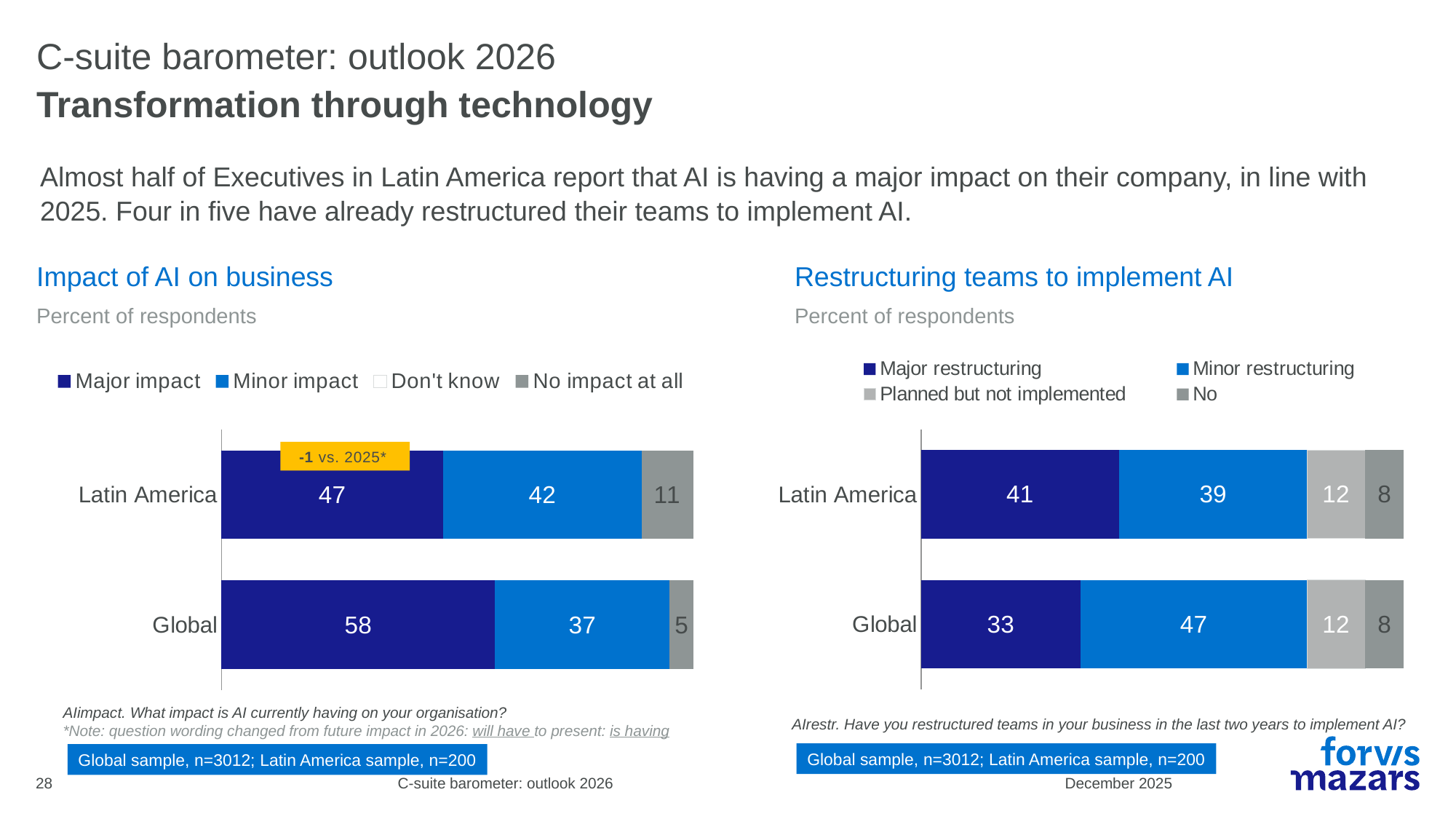
What kind of chart is the 'Restructuring teams to implement AI' chart? Stacked bar chart In the 'Restructuring teams to implement AI' chart, what is the total of the Latin America stacked bar? 100 In the 'Restructuring teams to implement AI' chart, how many categories (regions) are shown? 2 In the 'Impact of AI on business' chart, what percentage of Latin America respondents report a major impact? 47 In the 'Restructuring teams to implement AI' chart, what is the Latin America value for 'Major restructuring'? 41 In the 'Impact of AI on business' chart, how many series does the legend list? 4 In the 'Impact of AI on business' chart, what change versus 2025 is shown in the callout on the Latin America bar? -1 vs. 2025* In the 'Impact of AI on business' chart, which region has the larger value for 'No impact at all'? Latin America In the 'Restructuring teams to implement AI' chart, what is the Global value for 'Minor restructuring'? 47 In the 'Impact of AI on business' chart, what is the difference between the Global and Latin America values for 'Major impact'? 11 In the 'Impact of AI on business' chart, what is the Global value for 'Minor impact'? 37 In the 'Restructuring teams to implement AI' chart, what is the difference between the Latin America and Global values for 'Major restructuring'? 8